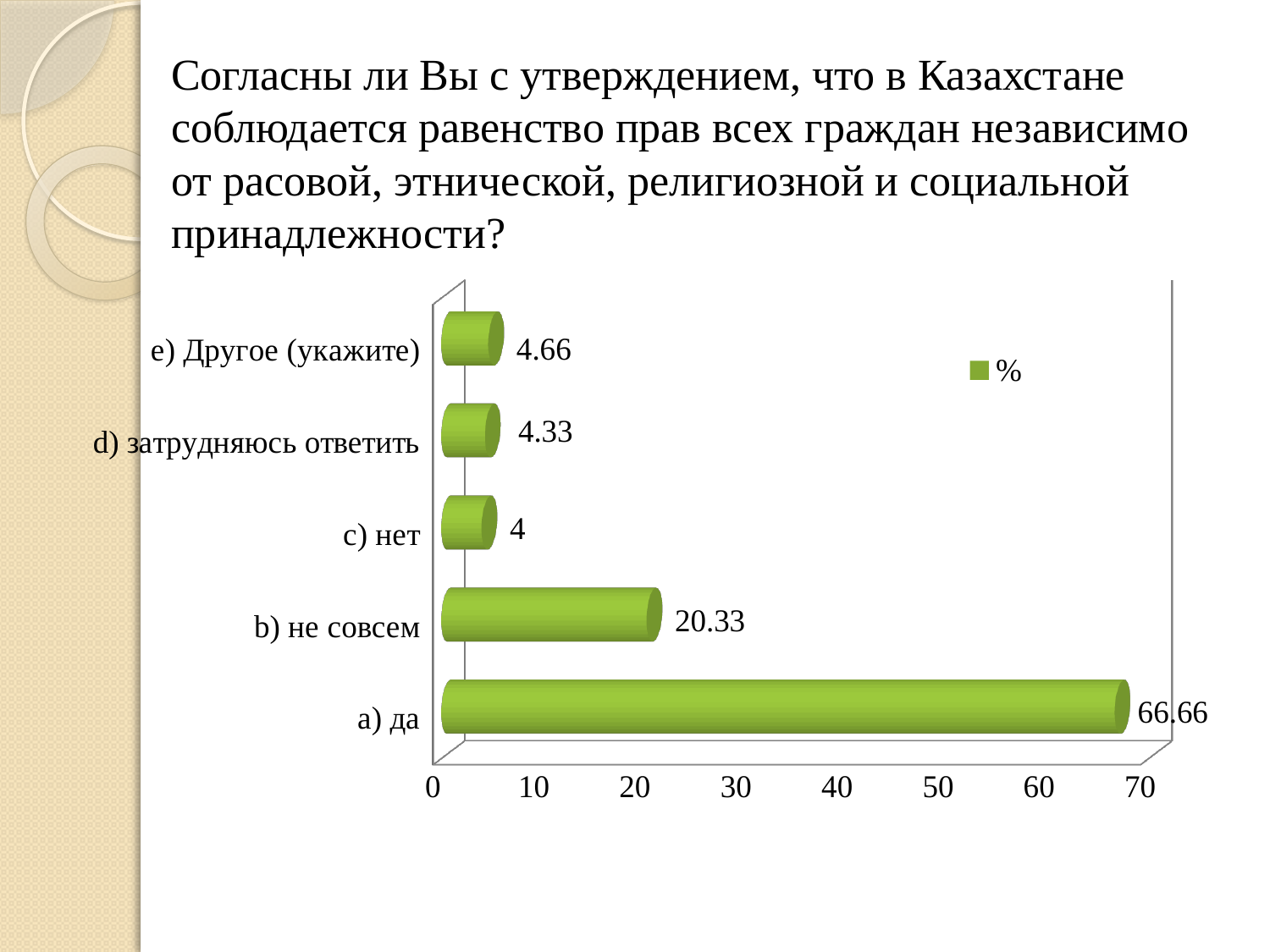
What is the value for "e) Другое (укажите)"? 4.66 What is the value for "c) нет"? 4 What is the value for "a) да"? 66.66 Which category has the lowest value? c) нет What is the difference between the values for "a) да" and "b) не совсем"? 46.33 How many categories are shown in the chart? 5 What is the value for "b) не совсем"? 20.33 What kind of chart is shown on the slide? bar chart Which category has the highest value? a) да What is the legend entry shown in the chart? % Which is larger, the value for "b) не совсем" or the value for "c) нет"? b) не совсем What is the value for "d) затрудняюсь ответить"? 4.33